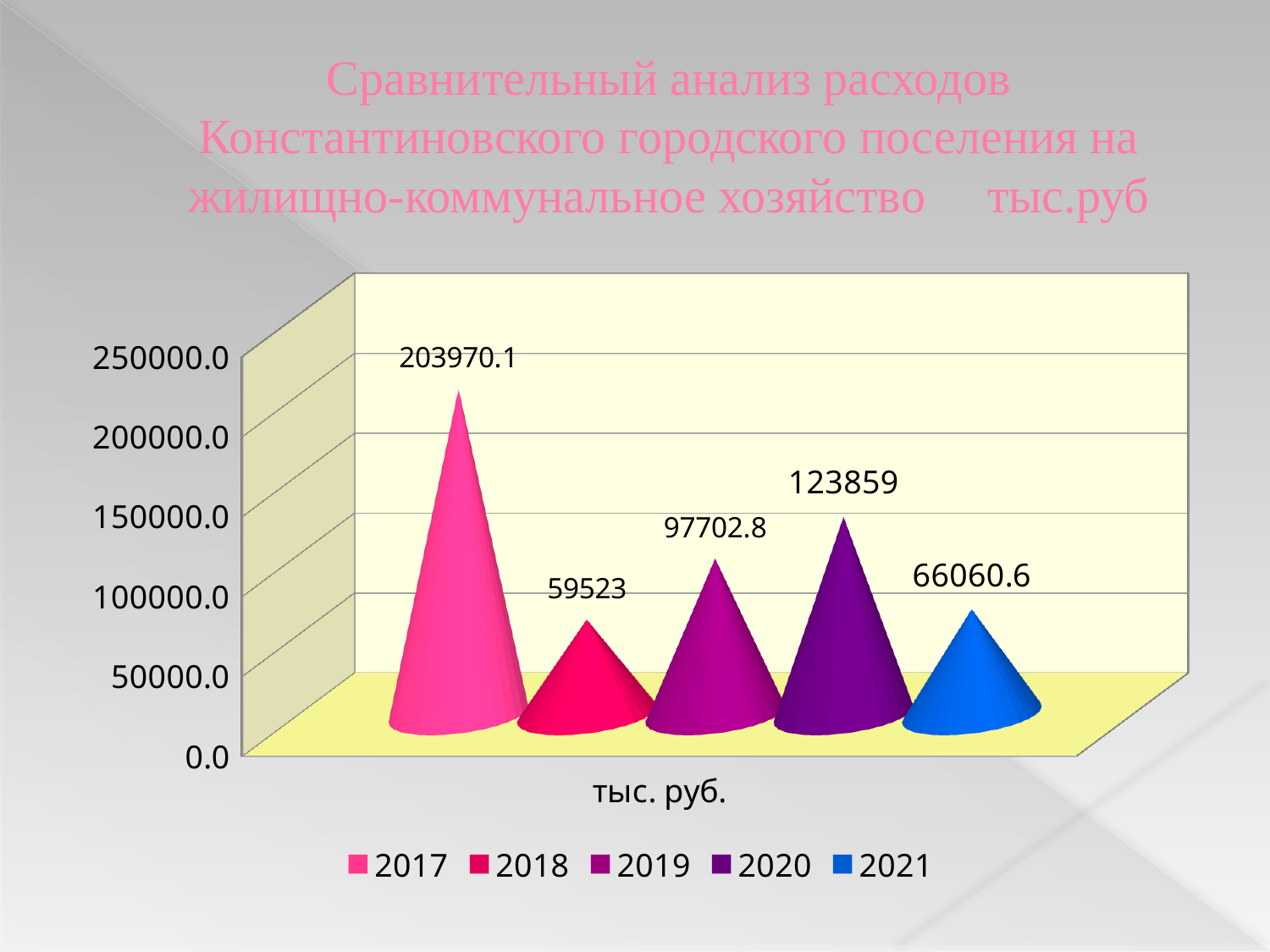
What is the value for 2021? 66060.6 What is the value for 2017? 203970.1 What is the value for 2019? 97702.8 What is the value for 2018? 59523 Which year has the lowest value? 2018 What kind of chart is shown on the slide? bar chart What is the difference between the values for 2020 and 2019? 26156.2 What is the value for 2020? 123859 Which year has the highest value? 2017 What is the difference between the values for 2017 and 2018? 144447.1 How many series does the legend list? 5 Which is larger, the value for 2019 or the value for 2021? 2019